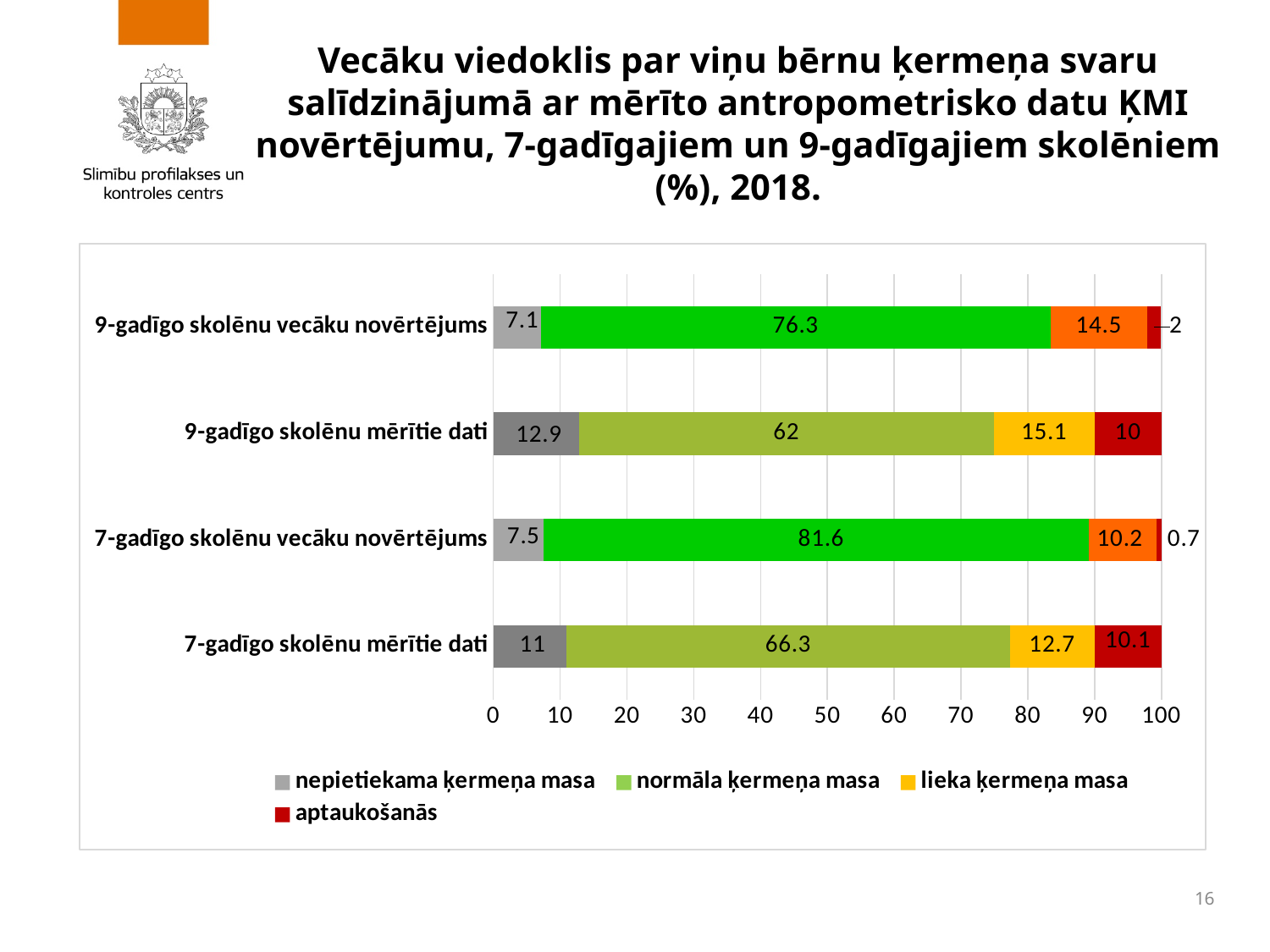
What is the value of lieka ķermeņa masa for 7-gadīgo skolēnu mērītie dati? 12.7 How many series does the legend list? 4 How many categories are shown on the chart? 4 Which has the larger lieka ķermeņa masa value: 9-gadīgo skolēnu mērītie dati or 9-gadīgo skolēnu vecāku novērtējums? 9-gadīgo skolēnu mērītie dati What is the value of normāla ķermeņa masa for 7-gadīgo skolēnu vecāku novērtējums? 81.6 What is the value of aptaukošanās for 9-gadīgo skolēnu mērītie dati? 10 Which category has the highest value for normāla ķermeņa masa? 7-gadīgo skolēnu vecāku novērtējums What is the value of nepietiekama ķermeņa masa for 9-gadīgo skolēnu vecāku novērtējums? 7.1 Which category has the lowest value for aptaukošanās? 7-gadīgo skolēnu vecāku novērtējums What kind of chart is shown on the slide? Stacked bar chart What is the total of the stacked bar for 9-gadīgo skolēnu mērītie dati? 100 What is the difference between the normāla ķermeņa masa values for 7-gadīgo skolēnu vecāku novērtējums and 7-gadīgo skolēnu mērītie dati? 15.3